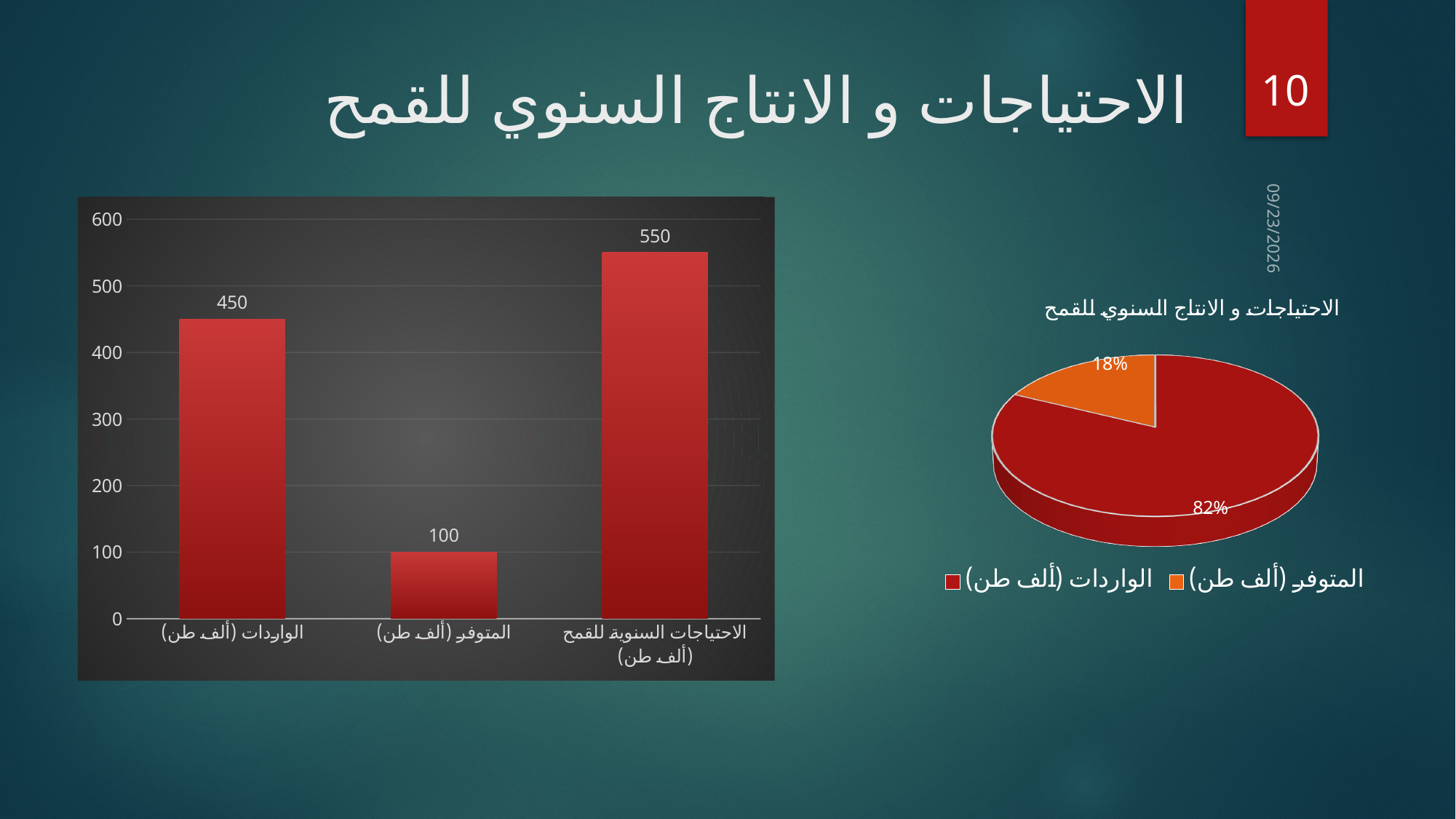
In the bar chart on the left, what is the value for الواردات (ألف طن)? 450 In the pie chart on the right, what share does الواردات (ألف طن) have? 82% How many entries does the legend of the pie chart on the right list? 2 In the bar chart on the left, which is larger: الواردات (ألف طن) or المتوفر (ألف طن)? الواردات (ألف طن) In the bar chart on the left, what is the difference between الاحتياجات السنوية للقمح (ألف طن) and الواردات (ألف طن)? 100 In the bar chart on the left, what is the value for الاحتياجات السنوية للقمح (ألف طن)? 550 What kind of chart is shown on the left of the slide? bar chart How many bars are shown in the bar chart on the left? 3 In the pie chart on the right, what share does المتوفر (ألف طن) have? 18% In the bar chart on the left, which category has the highest value? الاحتياجات السنوية للقمح (ألف طن) In the bar chart on the left, which category has the lowest value? المتوفر (ألف طن) In the bar chart on the left, what is the value for المتوفر (ألف طن)? 100